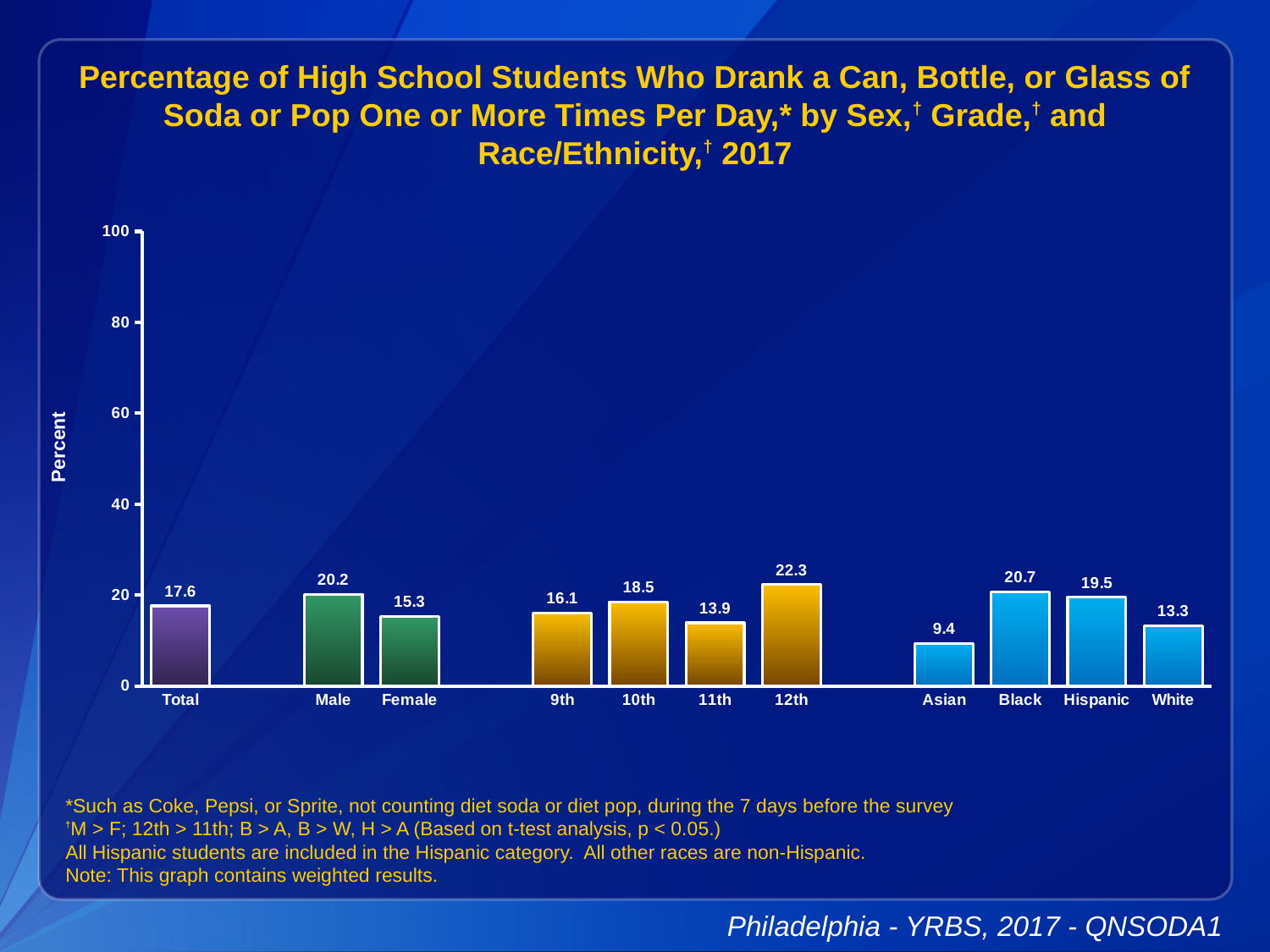
What is the difference between the values for Male and Female? 4.9 What is the value for Male? 20.2 What is the value for Asian? 9.4 Which category has the highest value? 12th What is the value for Total? 17.6 Which is larger, the value for Black or the value for White? Black What is the value for 12th grade? 22.3 Is the value for 11th grade greater or less than 20? less How many categories are shown on the x axis? 11 What is the label of the y axis? Percent Which category has the lowest value? Asian What kind of chart is this? bar chart